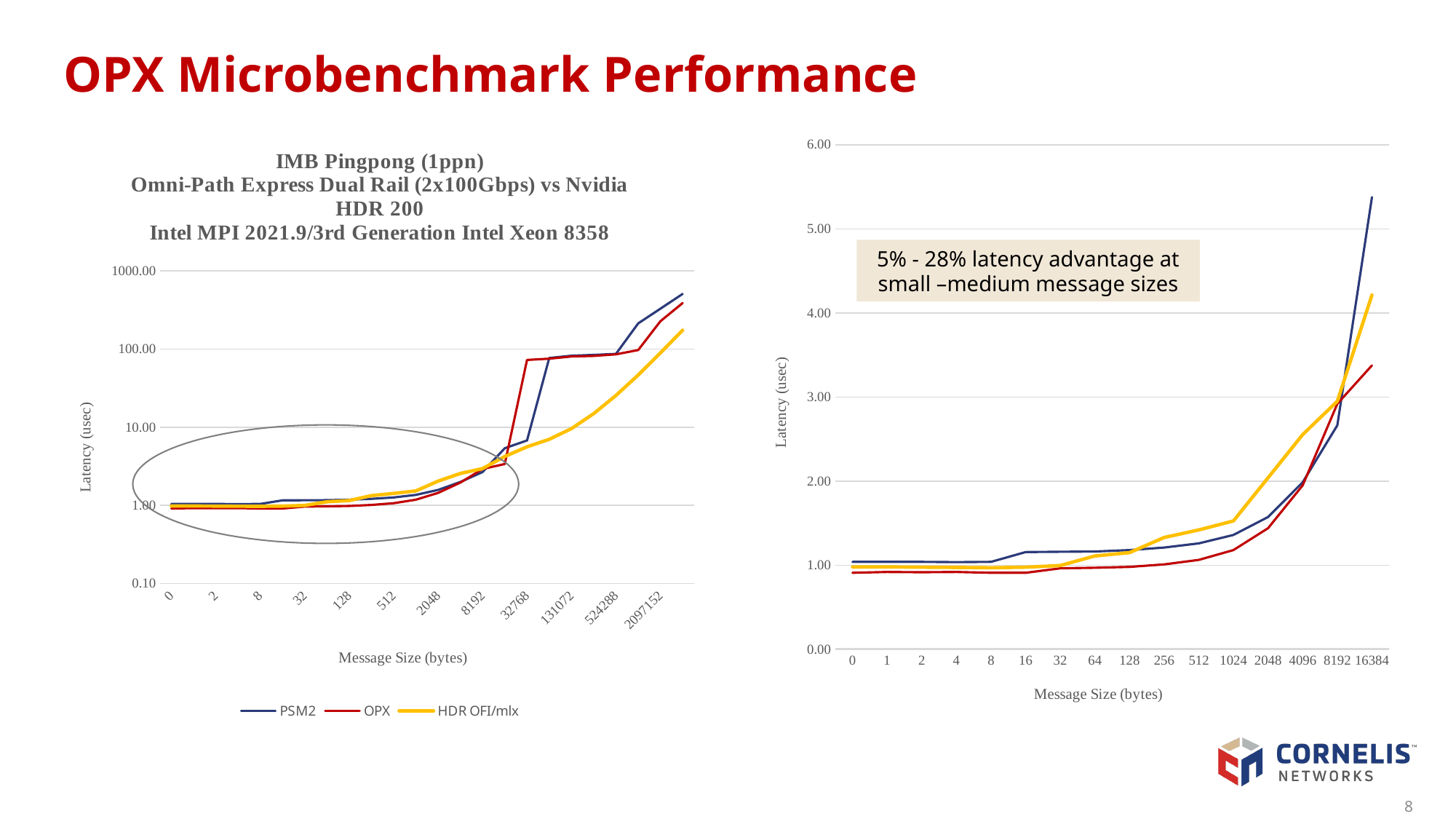
On the right chart, is the OPX (red) value at message size 16384 greater or less than 4.00? less How many series does the legend of the left chart list? 3 On the left chart, is the OPX value at message size 32768 greater or less than 10.00? greater What kind of chart is the left chart titled "IMB Pingpong (1ppn)"? line chart How many message-size categories are shown on the x axis of the right chart? 16 On the left chart, which series is drawn in yellow according to the legend? HDR OFI/mlx On the left chart, do the latency values generally rise or fall as message size increases? rise On the right chart, at message size 0, which is larger: the PSM2 (blue) value or the OPX (red) value? PSM2 What is the y-axis label of the left chart? Latency (usec) On the right chart, is the PSM2 (blue) value at message size 16384 greater or less than 5.00? greater On the left chart, which series has the lowest latency at message size 2097152? HDR OFI/mlx On the right chart, which series has the highest latency at message size 16384? PSM2